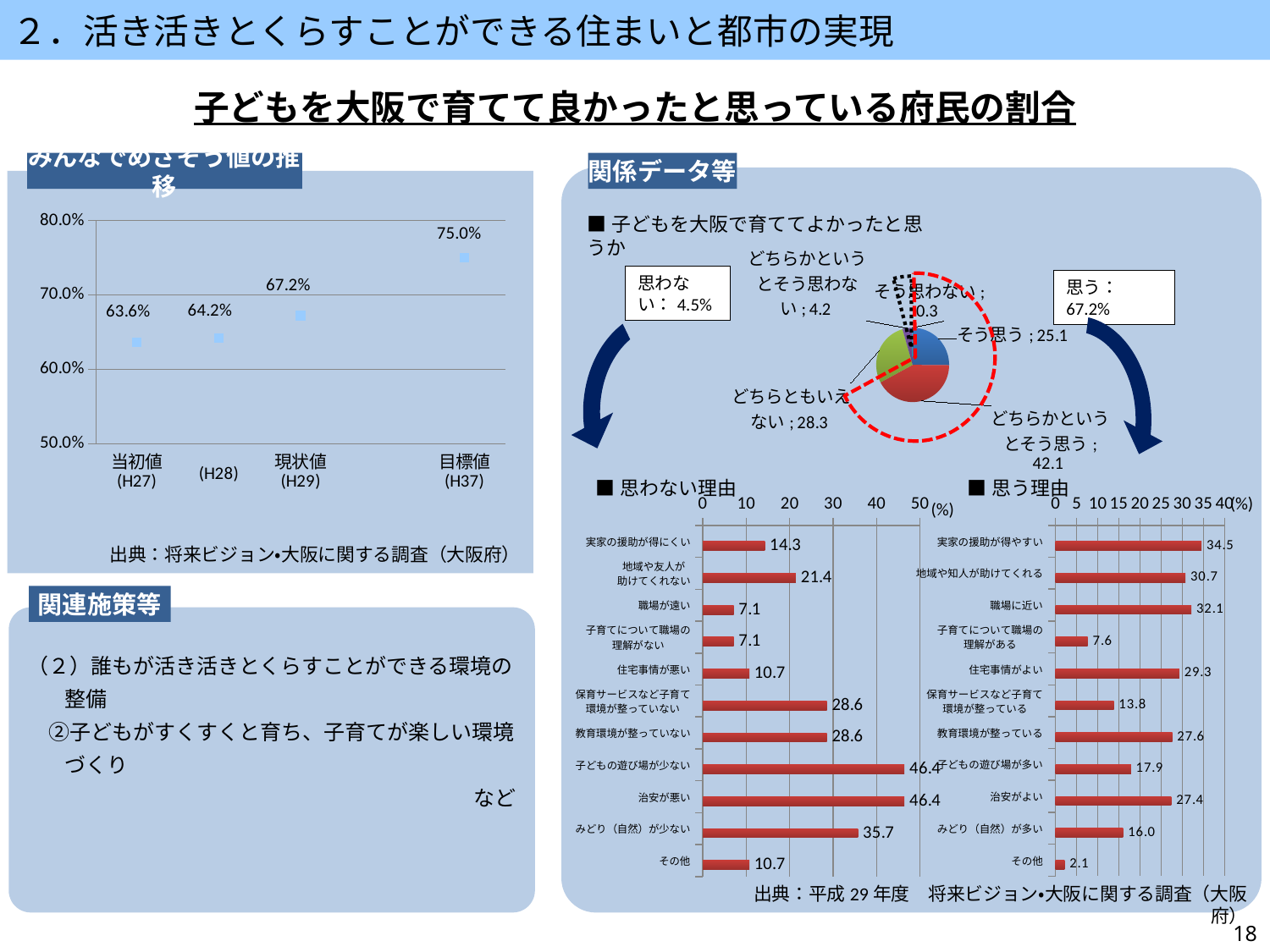
In the bar chart 思わない理由, what is the value for みどり（自然）が少ない? 35.7 In the pie chart 子どもを大阪で育ててよかったと思うか, which slice is the largest? どちらかというとそう思う In the chart titled みんなでめざそう値の推移, do the values rise or fall from 当初値 (H27) to 目標値 (H37)? rise In the bar chart 思う理由, which is larger: 住宅事情がよい or 治安がよい? 住宅事情がよい In the bar chart 思わない理由, which category has the lowest value? 職場が遠い and 子育てについて職場の理解がない (both 7.1) In the pie chart 子どもを大阪で育ててよかったと思うか, how many slices are there? 5 In the bar chart 思う理由, what is the difference between 職場に近い and 子育てについて職場の理解がある? 24.5 In the chart titled みんなでめざそう値の推移, what is the difference between 現状値 (H29) and (H28)? 3.0% In the chart titled みんなでめざそう値の推移, what is the value for 当初値 (H27)? 63.6% In the chart titled みんなでめざそう値の推移, what is the value for 目標値 (H37)? 75.0% In the pie chart 子どもを大阪で育ててよかったと思うか, what is the value for どちらかというとそう思う? 42.1 In the bar chart 思う理由, which category has the highest value? 実家の援助が得やすい